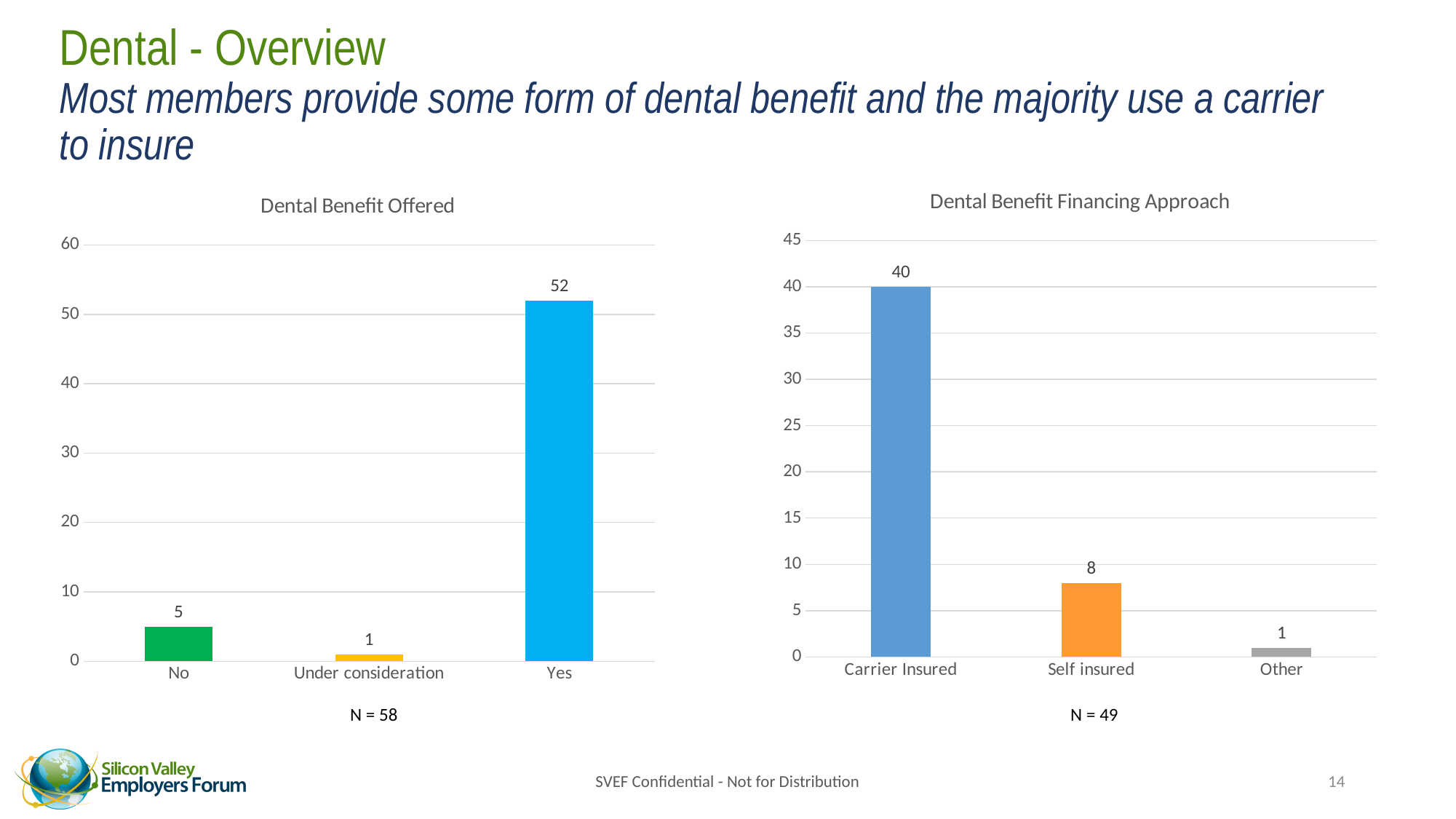
In the 'Dental Benefit Financing Approach' chart, what is the difference between Carrier Insured and Self insured? 32 In the 'Dental Benefit Offered' chart, what is the difference between the values for Yes and No? 47 In the 'Dental Benefit Offered' chart, how many categories are shown? 3 What kind of chart is the 'Dental Benefit Financing Approach' chart? Bar chart What is the sample size (N) shown under the 'Dental Benefit Offered' chart? N = 58 In the 'Dental Benefit Offered' chart, what is the value for No? 5 In the 'Dental Benefit Financing Approach' chart, what is the value for Carrier Insured? 40 In the 'Dental Benefit Offered' chart, which category has the lowest value? Under consideration In the 'Dental Benefit Financing Approach' chart, what is the value for Self insured? 8 In the 'Dental Benefit Offered' chart, what is the value for Yes? 52 In the 'Dental Benefit Financing Approach' chart, which is larger, Self insured or Other? Self insured In the 'Dental Benefit Financing Approach' chart, which category has the highest value? Carrier Insured